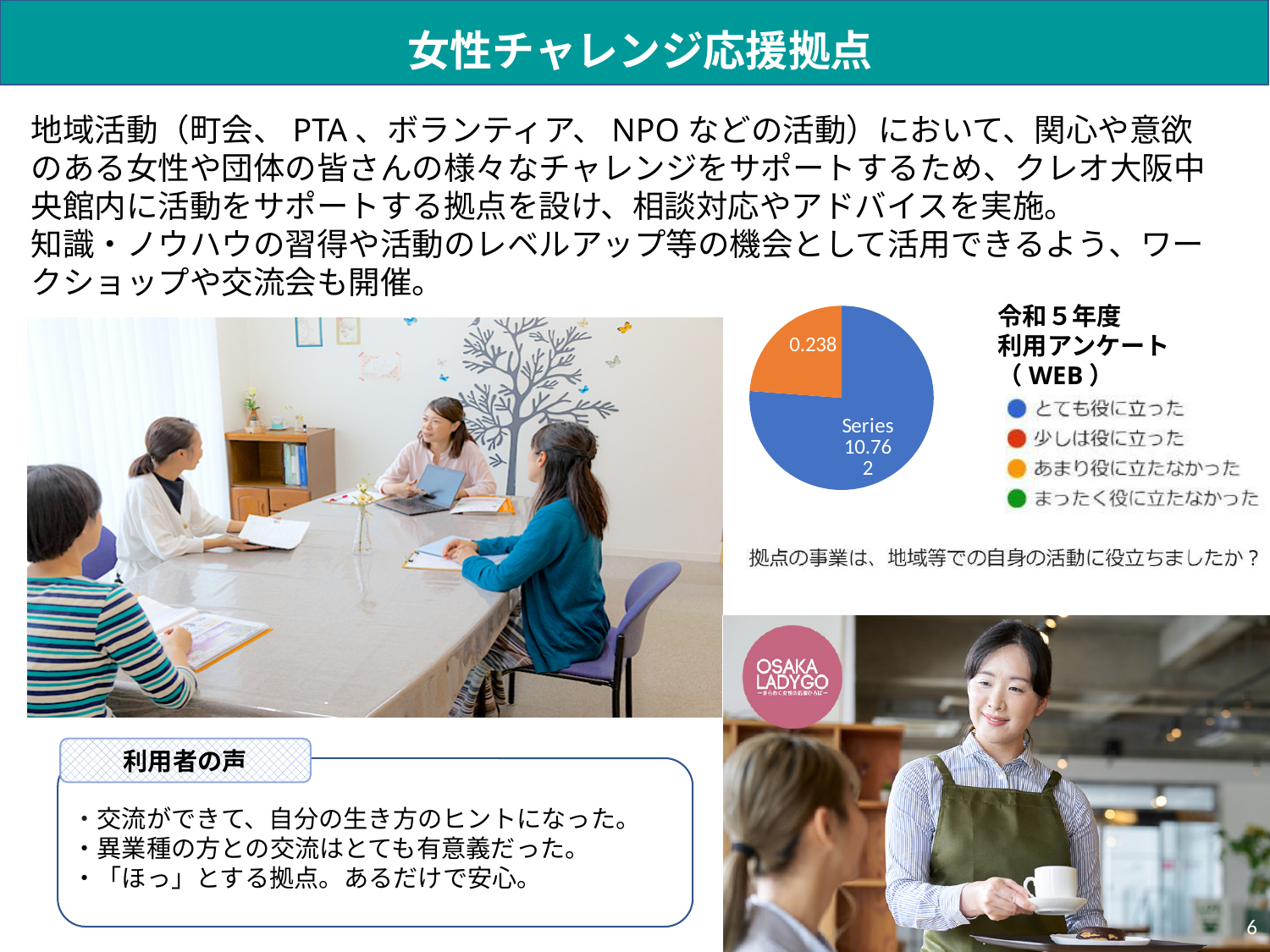
Is the value of the orange slice of the pie chart greater or less than 0.5? less What value is printed on the orange slice of the pie chart? 0.238 Is the blue slice or the orange slice of the pie chart larger? the blue slice Which slice of the pie chart is the largest? the blue slice Which slice of the pie chart is the smallest? the orange slice What is the title shown above the legend of the pie chart? 令和5年度 利用アンケート（WEB） What is the first entry in the legend next to the pie chart? とても役に立った What kind of chart is shown on the slide? pie chart How many entries does the legend next to the pie chart list? 4 How many slices does the pie chart have? 2